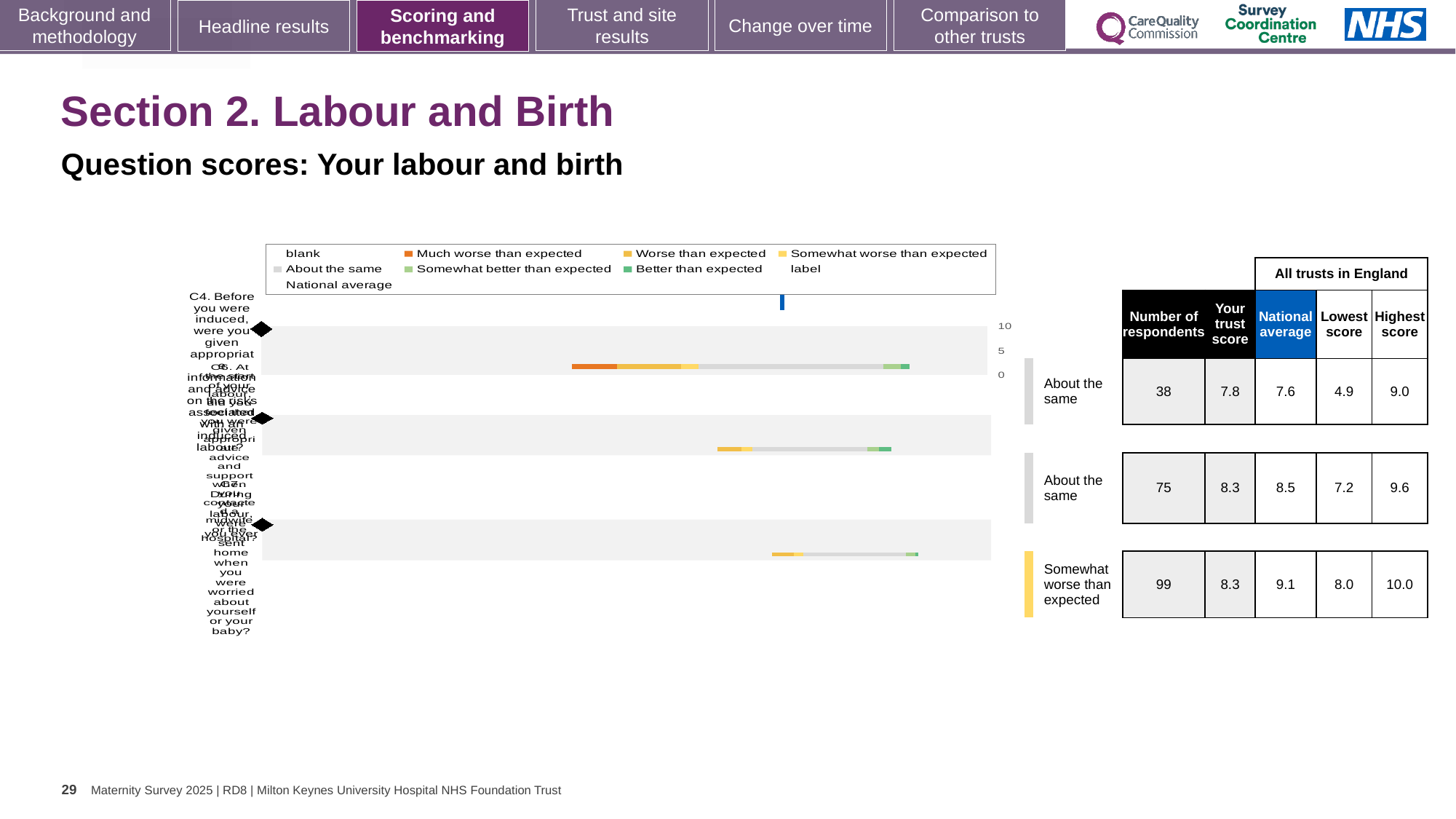
What is the number of respondents for the first (top) question row? 38 For the first (top) question row, what is the difference between the highest score and the lowest score? 4.1 What is the trust score for the third (bottom) question row? 8.3 Which question row has the lowest trust score? the first (top) row What is the national average for the second (middle) question row? 8.5 Which question row has the highest number of respondents? the third (bottom) row For the third (bottom) question row, which is larger: the trust score or the national average? the national average For the first (top) question row, which is larger: the trust score or the national average? the trust score What benchmark category is shown for the third (bottom) question row? Somewhat worse than expected What kind of chart is shown on the slide? bar chart How many question rows (bars) does the chart show? 3 What is the highest score across all trusts in England for the third (bottom) question row? 10.0